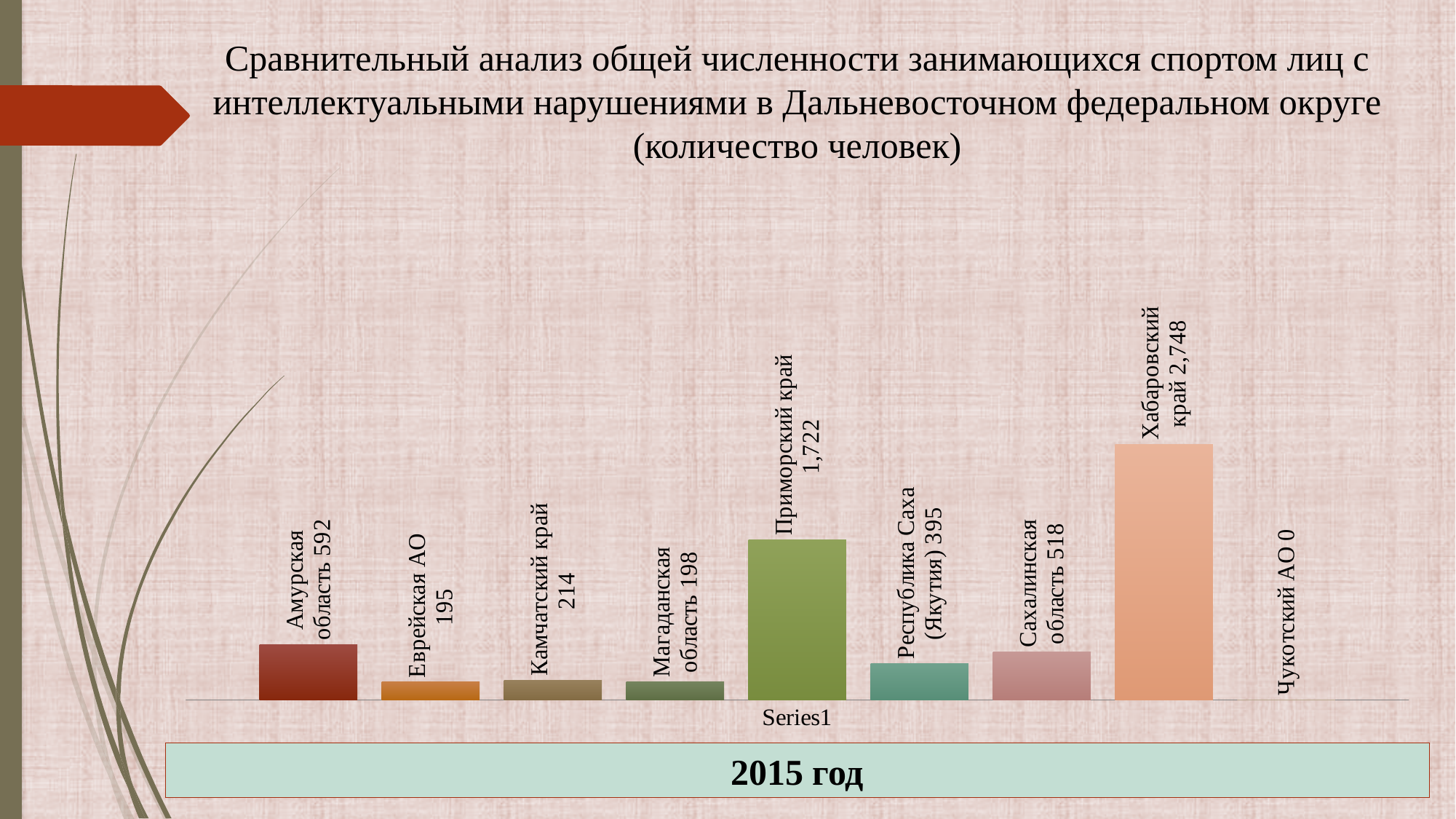
Which region has the highest value? Хабаровский край Which is larger, the value for Сахалинская область or the value for Амурская область? Амурская область What type of chart is shown on the slide? Bar chart What is the value for Амурская область? 592 What is the difference between the values for Камчатский край and Магаданская область? 16 What is the difference between the values for Хабаровский край and Приморский край? 1,026 What is the value for Приморский край? 1,722 What is the value for Хабаровский край? 2,748 What is the value for Республика Саха (Якутия)? 395 Which region has the lowest value? Чукотский АО Which year does the chart refer to, according to the label below it? 2015 год How many regions are shown in the chart? 9